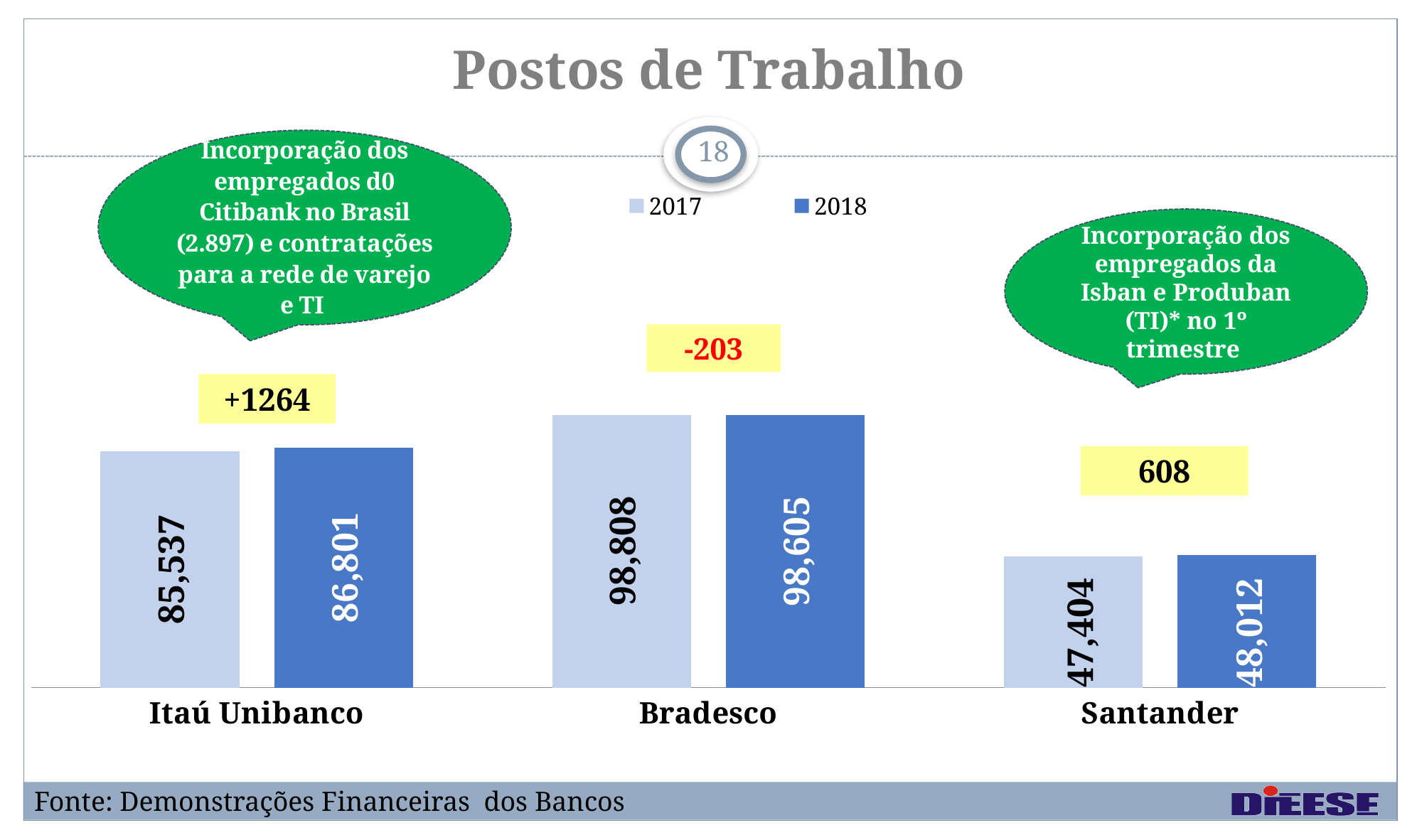
What kind of chart is shown on the slide? Bar chart What is the 2018 value for Santander? 48,012 Which bank has the highest 2018 value? Bradesco What is the difference between the 2018 and 2017 values for Itaú Unibanco? 1,264 How many series does the legend list? 2 Which bank has the lowest 2017 value? Santander What is the 2018 value for Bradesco? 98,605 What is the 2017 value for Itaú Unibanco? 85,537 What is the 2017 value for Santander? 47,404 What is the difference between the 2017 and 2018 values for Bradesco? 203 Which is larger for Santander, the 2017 value or the 2018 value? 2018 How many banks are shown on the x axis? 3